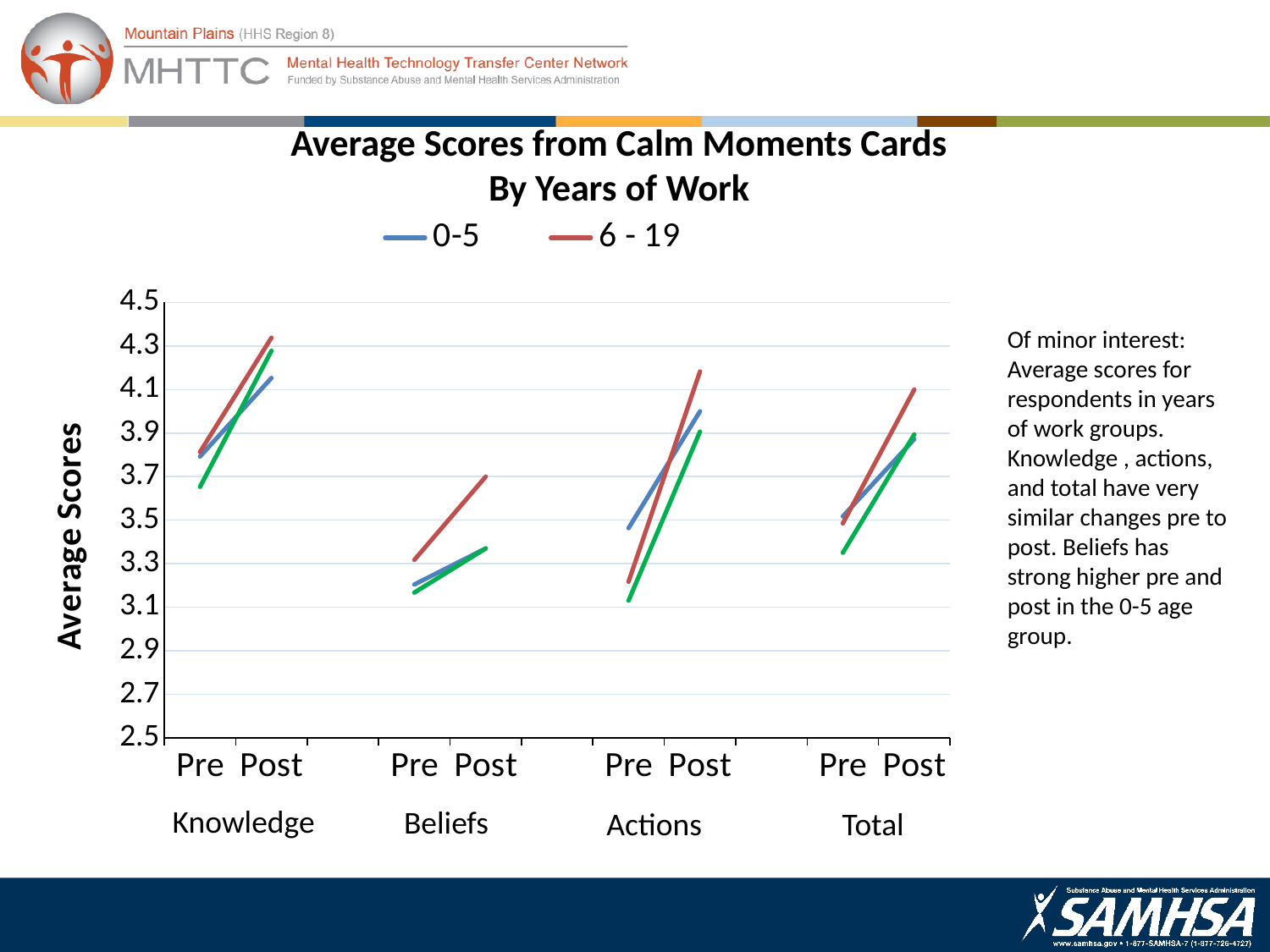
Do the scores rise or fall from Pre to Post for the 6 - 19 series in every category? rise For the 6 - 19 series, which category has the highest Post value? Knowledge How many topic categories (Knowledge, Beliefs, etc.) are shown along the x axis? 4 Is the Actions Pre value for the 6 - 19 series greater or less than 3.3? less Is the Beliefs Pre value for the 0-5 series greater or less than 3.3? less How many series does the legend list? 2 What is the title of the chart? Average Scores from Calm Moments Cards By Years of Work For Beliefs Post, which series has the higher value, 0-5 or 6 - 19? 6 - 19 Is the Knowledge Post value for the 6 - 19 series greater or less than 4.1? greater What is the label on the vertical axis? Average Scores What kind of chart is shown on the slide? line chart